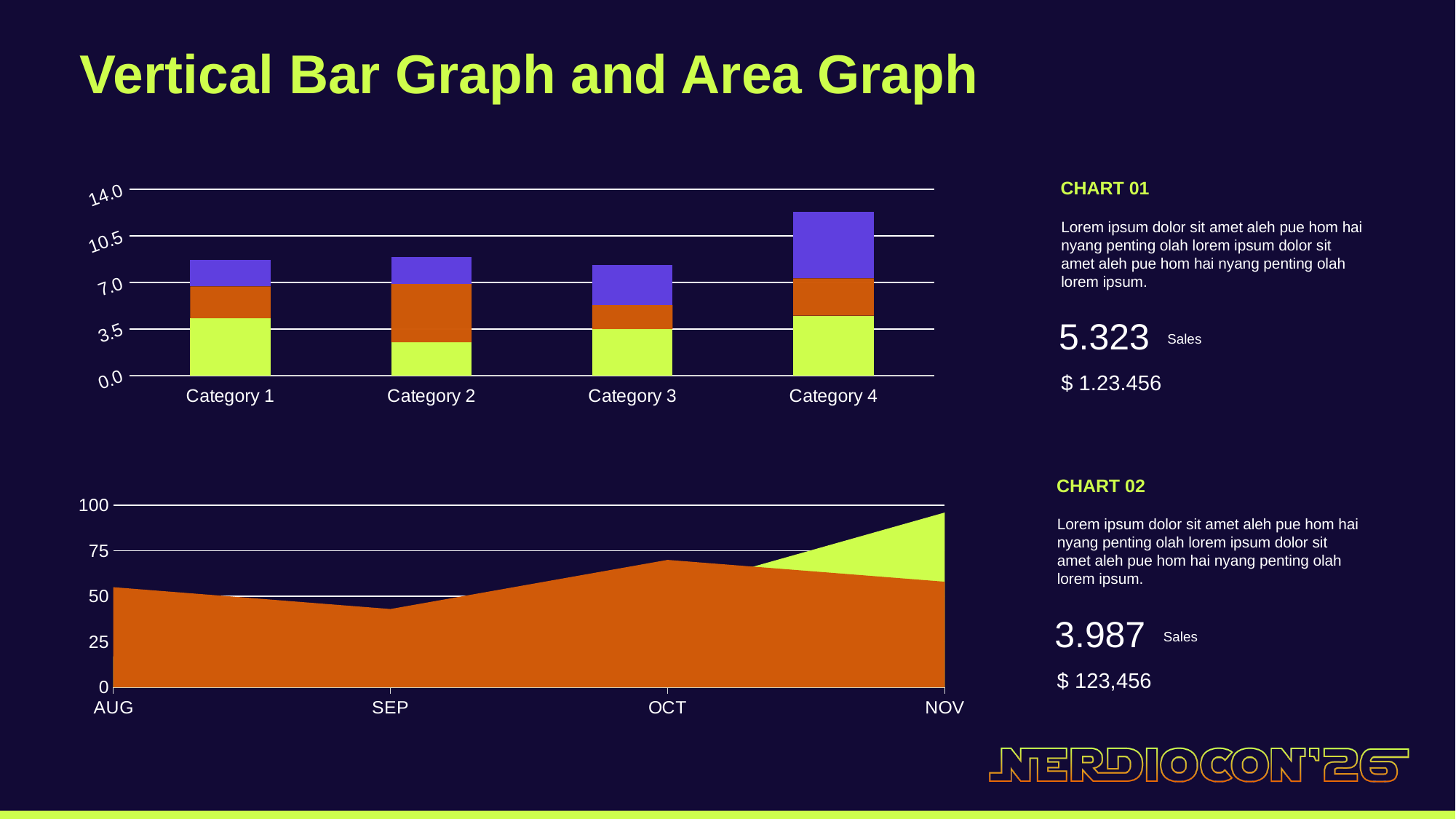
What kind of chart is the top chart on the slide? bar chart In the bottom area chart, does the orange area rise or fall from SEP to OCT? rises In the top bar chart, which category has the tallest stacked bar? Category 4 In the top bar chart, how many categories are shown on the x axis? 4 In the top bar chart, is the total height of the Category 1 bar greater or less than 10.5? less In the top bar chart, is the total height of the Category 4 bar greater or less than 10.5? greater In the top bar chart, is the green (bottom) segment of Category 2 greater or less than 3.5? less In the bottom area chart, how many months are labelled on the x axis? 4 In the bottom area chart, at which month does the green area reach its highest point? NOV What kind of chart is the bottom chart on the slide? area chart